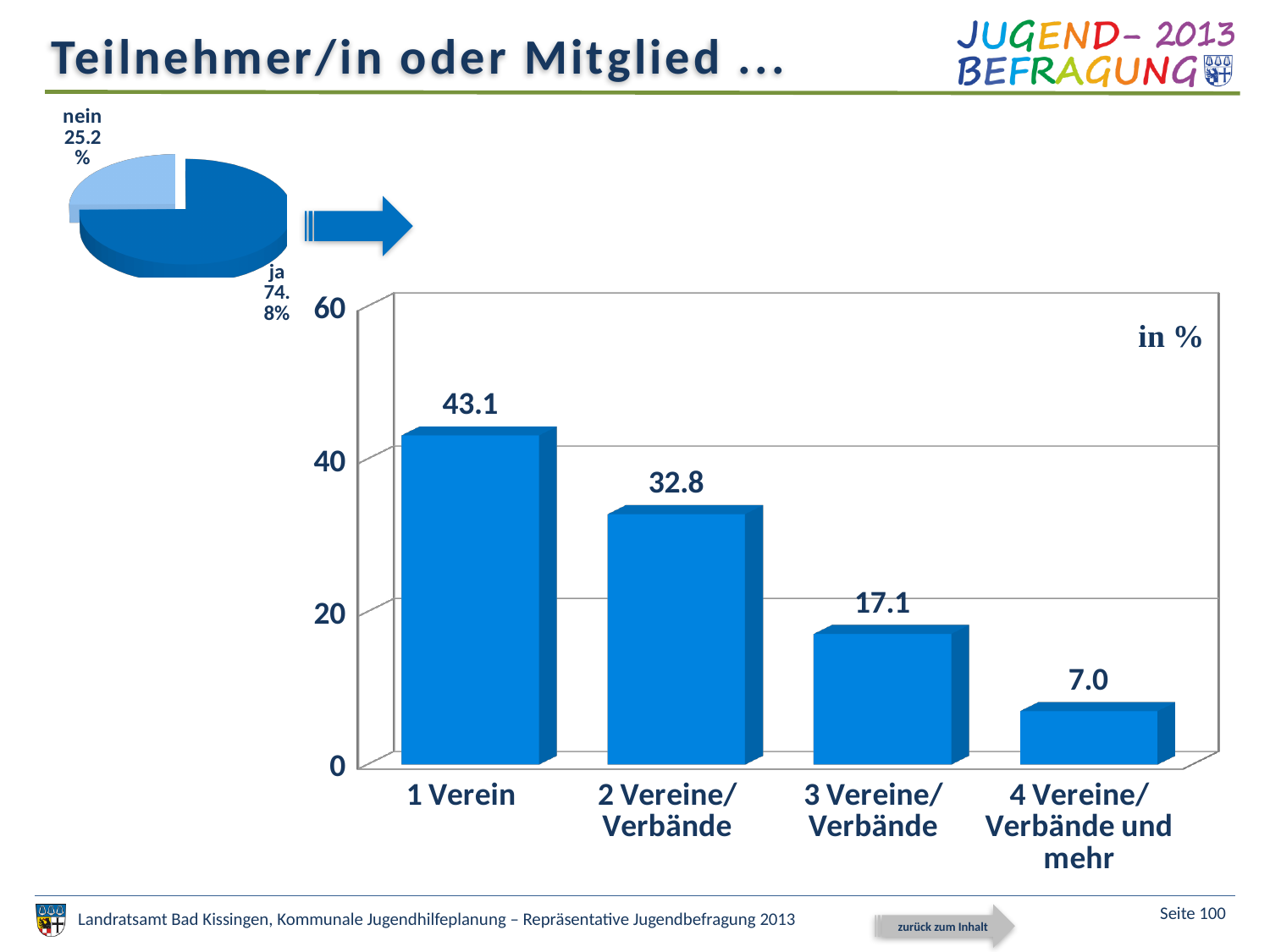
In the bar chart, what is the value for 4 Vereine/Verbände und mehr? 7.0 In the bar chart, how many categories are shown? 4 In the bar chart, which category has the lowest value? 4 Vereine/Verbände und mehr In the bar chart, which is larger: the value for 2 Vereine/Verbände or 3 Vereine/Verbände? 2 Vereine/Verbände What kind of chart is the chart in the top left of the slide? pie chart In the pie chart, what share does the 'nein' slice have? 25.2% In the bar chart, what is the difference between the values for 1 Verein and 2 Vereine/Verbände? 10.3 In the bar chart, which category has the highest value? 1 Verein In the bar chart, do the values rise or fall from left to right along the x axis? fall In the pie chart, what share does the 'ja' slice have? 74.8% In the bar chart, what is the value for 1 Verein? 43.1 In the bar chart, what is the value for 3 Vereine/Verbände? 17.1